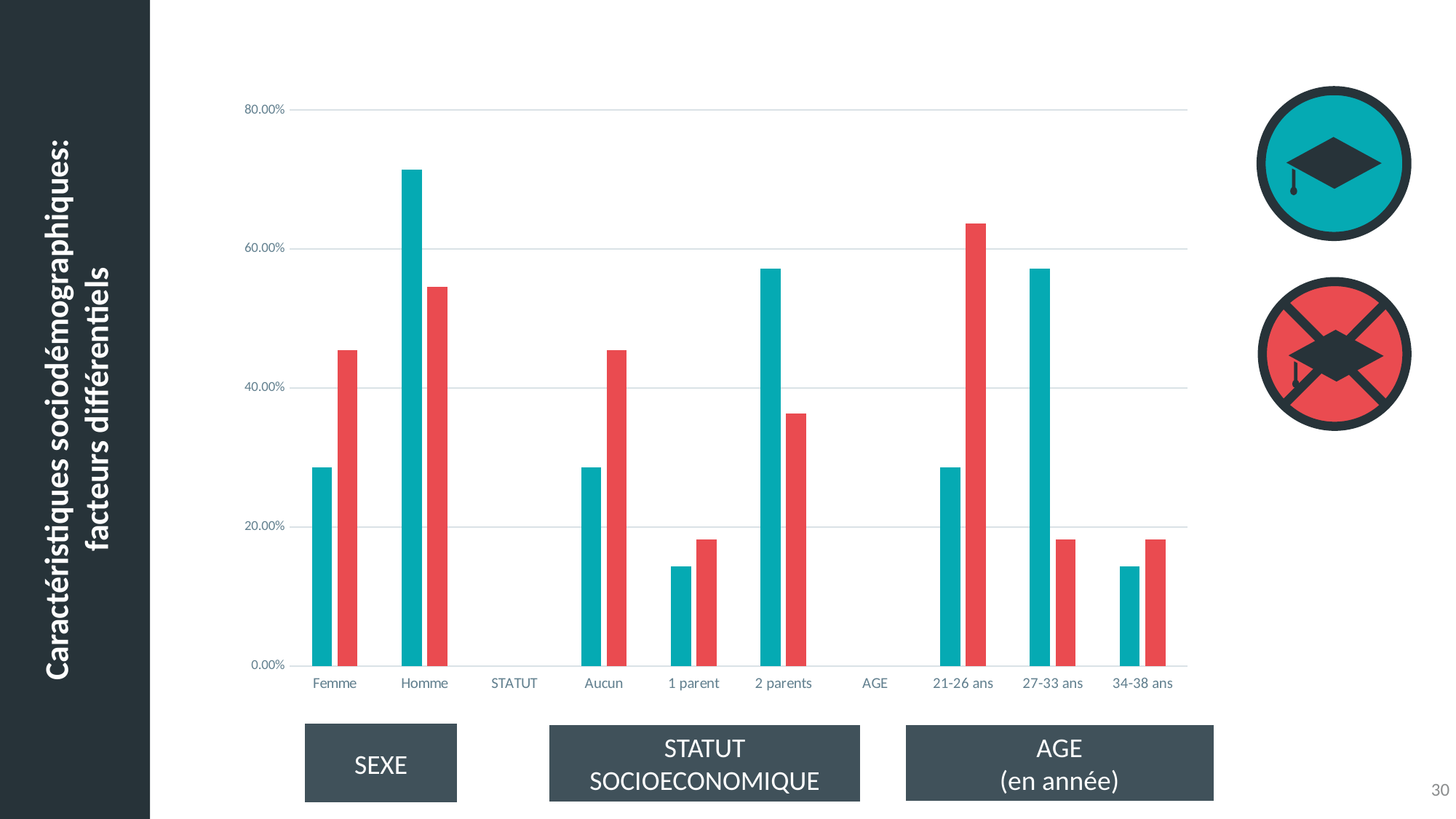
Is the teal bar for Homme greater or less than 60.00%? greater For 2 parents, which bar is taller, the teal one or the red one? the teal one What kind of chart is shown on the slide? bar chart For 27-33 ans, which bar is taller, the teal one or the red one? the teal one For Femme, which bar is taller, the teal one or the red one? the red one Is the red bar for 21-26 ans greater or less than 60.00%? greater What is the highest value shown on the vertical axis? 80.00% Is the teal bar for Femme greater or less than 40.00%? less How many groups of categories (labelled boxes below the chart) does the chart have? 3 Which category has the tallest red bar? 21-26 ans Which category has the tallest teal bar? Homme